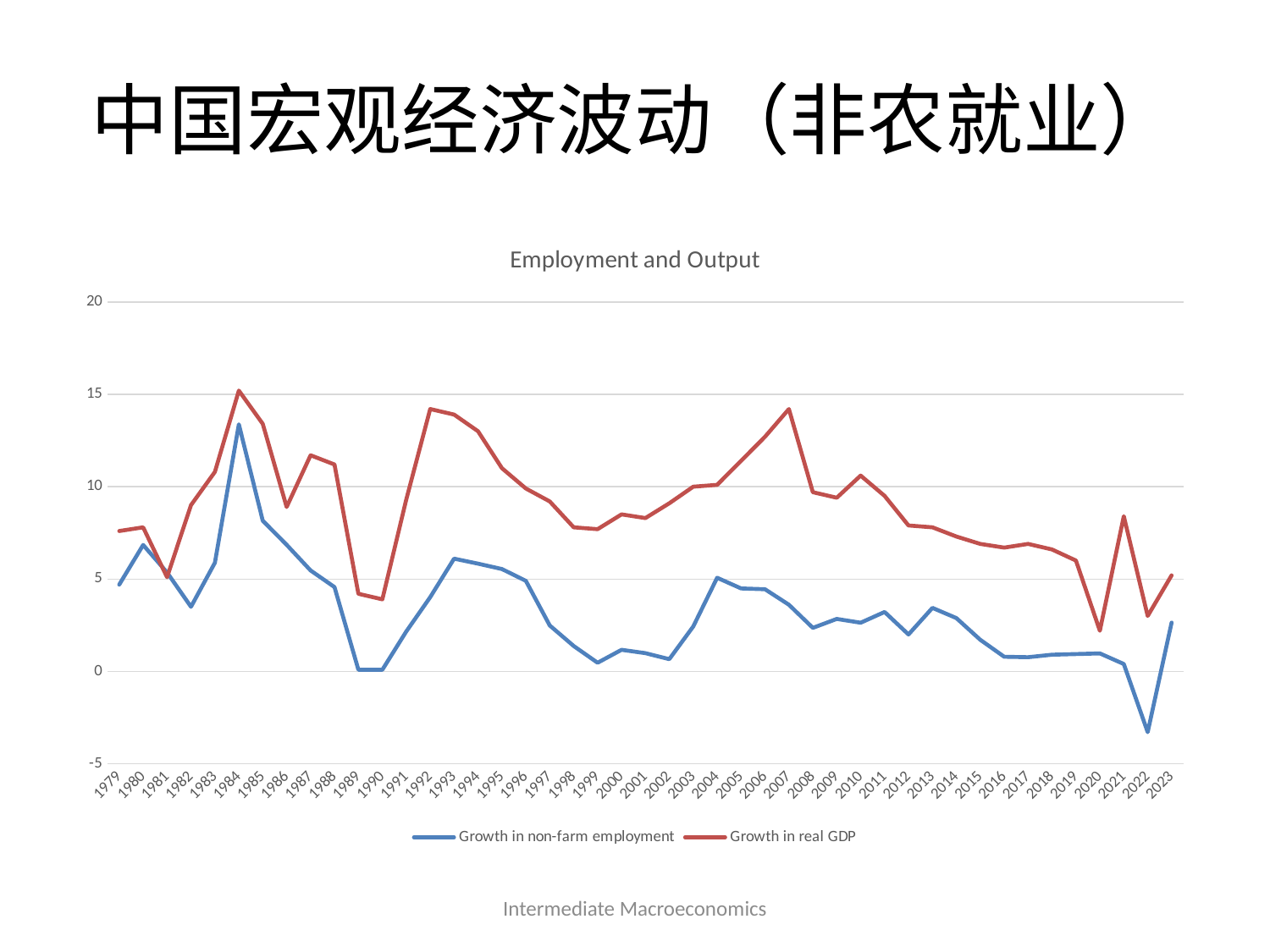
In which year does Growth in non-farm employment reach its highest value? 1984 What kind of chart is shown on the slide? line chart In which year does Growth in non-farm employment reach its lowest value? 2022 In which year does Growth in real GDP reach its highest value? 1984 What is the title of the chart? Employment and Output How many years are plotted along the x axis? 45 Which series is drawn in red? Growth in real GDP Is the value for Growth in non-farm employment in 2022 greater or less than 0? less Does Growth in non-farm employment rise or fall from 2013 to 2016? fall In 2007, which series has the larger value, Growth in real GDP or Growth in non-farm employment? Growth in real GDP How many series does the legend list? 2